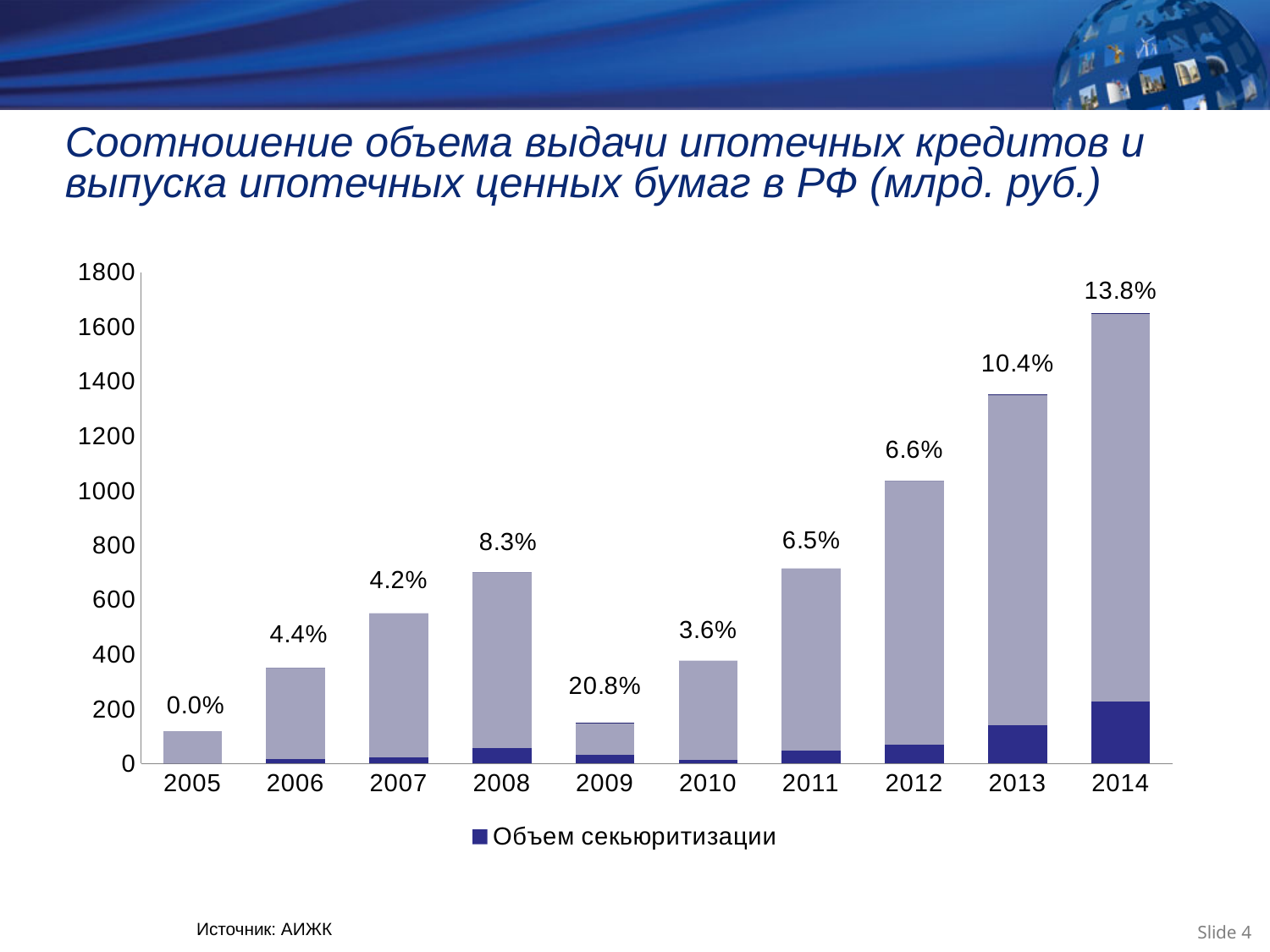
Is the total bar height for 2014 greater or less than 1600? greater What is the difference between the percentage labels for 2014 and 2013? 3.4% What percentage label is shown above the bar for 2014? 13.8% Which year has the lowest percentage label on the chart? 2005 What percentage label is shown above the bar for 2009? 20.8% Which year has the larger percentage label, 2008 or 2010? 2008 What percentage label is shown above the bar for 2011? 6.5% How many years are shown on the x axis of the chart? 10 What kind of chart is shown on the slide? Bar chart Which year has the highest percentage label on the chart? 2009 What percentage label is shown above the bar for 2005? 0.0% Is the total bar height for 2009 greater or less than 200? less